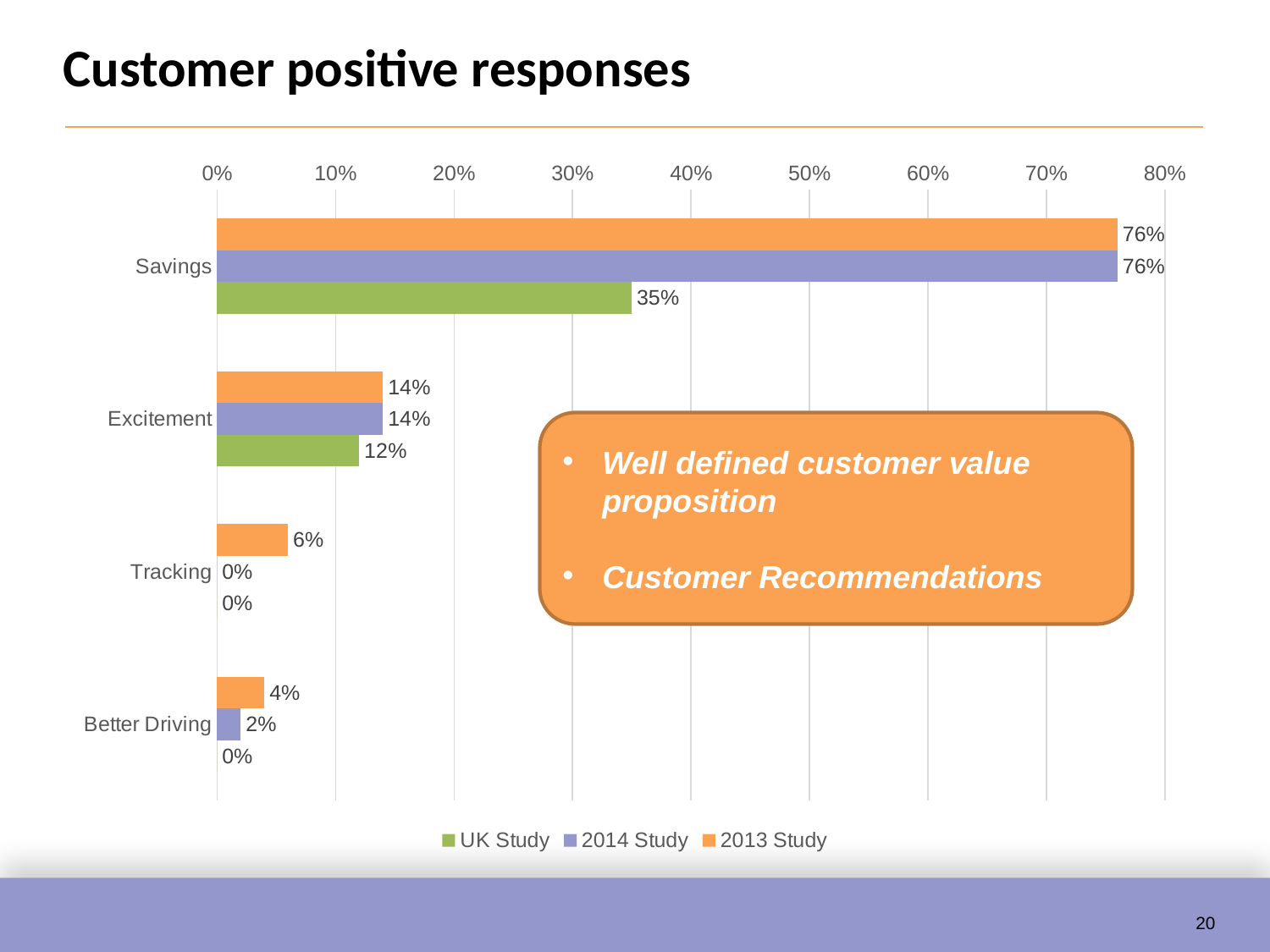
What is the value for Better Driving in the 2014 Study series? 2% How many series does the legend list? 3 What kind of chart is shown on the slide? Bar chart Which is larger for Excitement: the 2014 Study value or the UK Study value? 2014 Study Which category has the lowest value in the 2013 Study series? Better Driving What is the value for Excitement in the 2013 Study series? 14% Which series is shown in green in the legend? UK Study Which category has the highest value in the 2014 Study series? Savings What is the value for Tracking in the 2013 Study series? 6% What is the value for Savings in the UK Study series? 35% How many categories are shown on the chart? 4 What is the difference between the 2013 Study and UK Study values for Savings? 41%